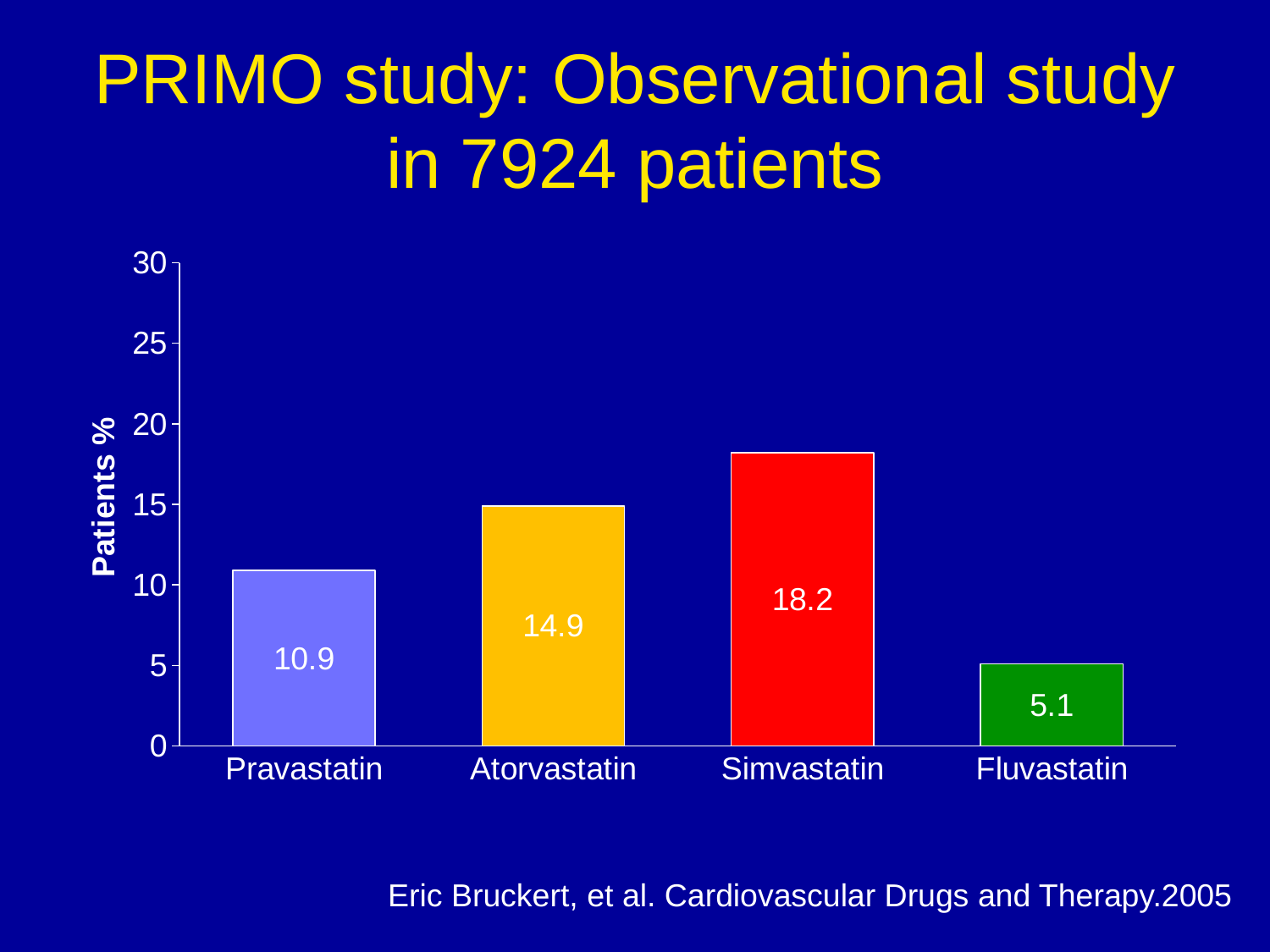
What is the value for Pravastatin? 10.9 What is the value for Fluvastatin? 5.1 Which is larger, the value for Atorvastatin or the value for Pravastatin? Atorvastatin What is the label of the y axis? Patients % How many statins are shown on the chart? 4 Which statin has the highest percentage of patients? Simvastatin What is the value for Simvastatin? 18.2 Is the value for Simvastatin greater or less than 20? less What kind of chart is shown on the slide? bar chart Which statin has the lowest percentage of patients? Fluvastatin What is the value for Atorvastatin? 14.9 What is the difference between the values for Simvastatin and Pravastatin? 7.3